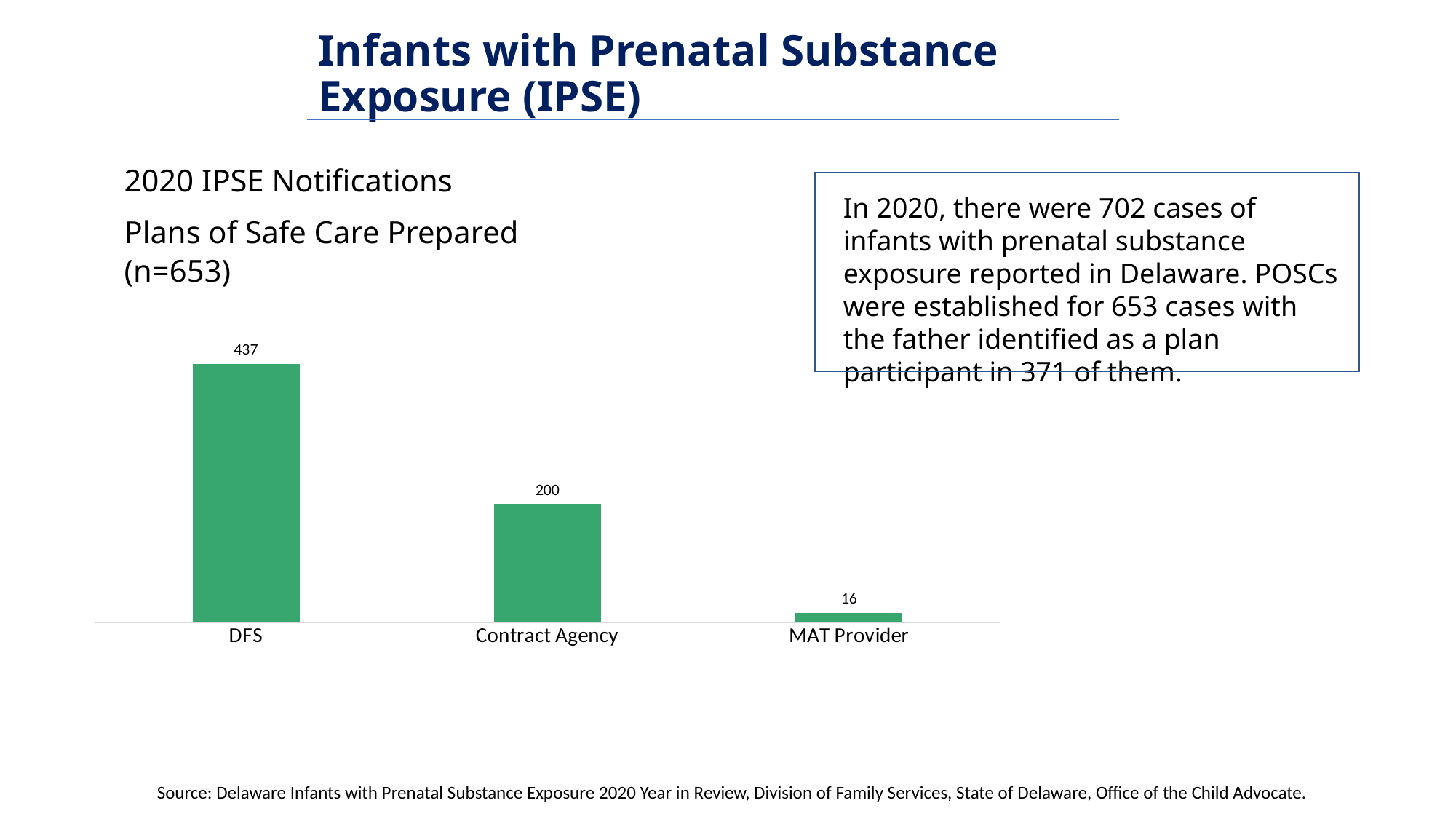
Which category has the lowest value? MAT Provider What is the value for DFS? 437 Which is larger, the value for Contract Agency or the value for MAT Provider? Contract Agency What is the value for Contract Agency? 200 What is the value for MAT Provider? 16 What kind of chart is shown on the slide? Bar chart What is the difference between the values for DFS and Contract Agency? 237 What is the total of the three values shown in the chart? 653 Do the values rise or fall from left to right across the categories? Fall What is the difference between the values for Contract Agency and MAT Provider? 184 How many categories are shown in the chart? 3 Which category has the highest value? DFS